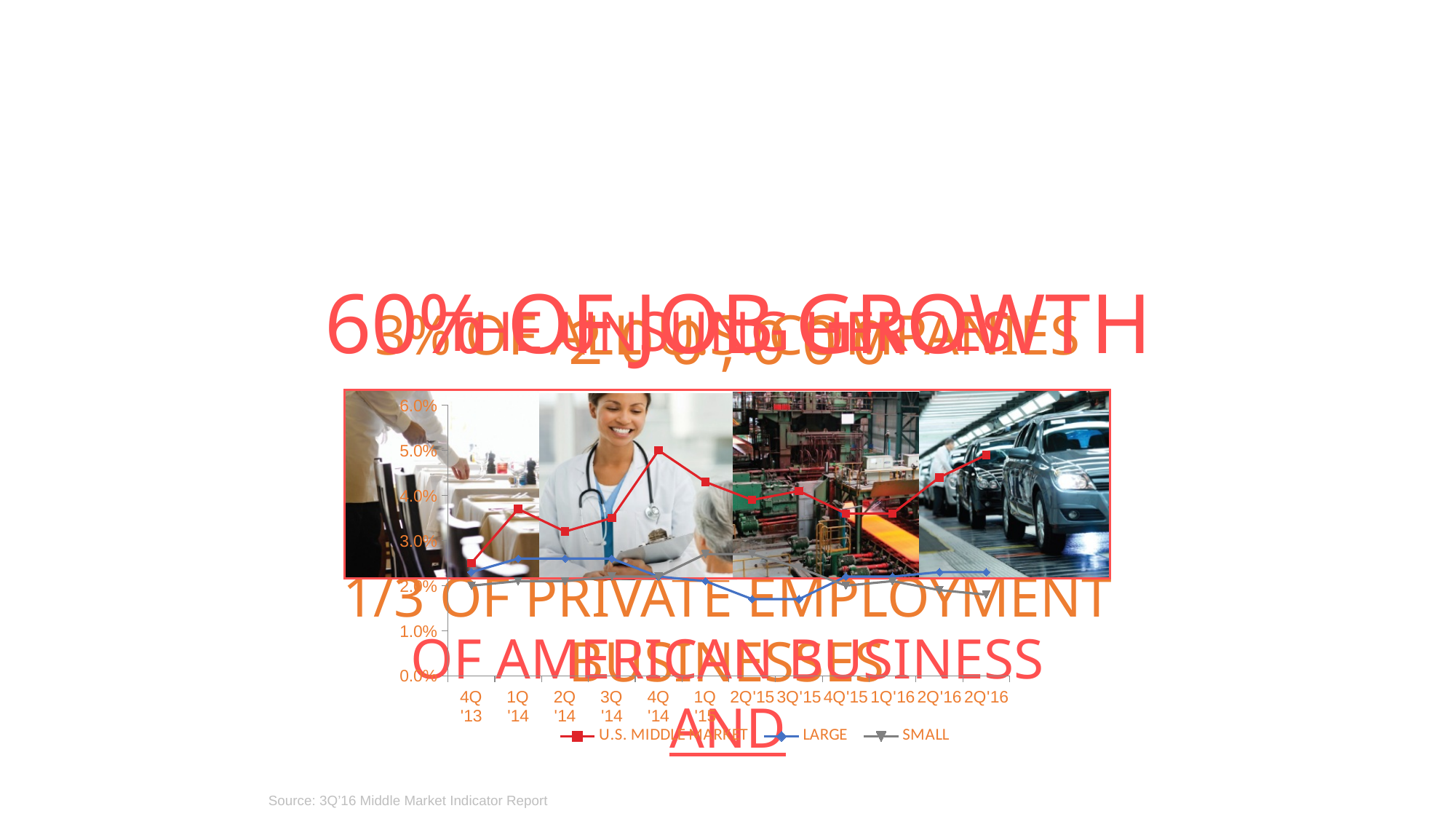
What kind of chart is shown on the slide? line chart Is the U.S. MIDDLE MARKET value at 4Q '14 greater or less than 4.0%? greater Does the U.S. MIDDLE MARKET series rise or fall from 4Q '13 to 4Q '14? rise Is the U.S. MIDDLE MARKET value at 4Q '13 greater or less than 3.0%? less How many series does the chart legend list? 3 Is the LARGE value at the final 2Q'16 point greater or less than 3.0%? less In which quarter does the U.S. MIDDLE MARKET series reach its highest value? 4Q '14 What source is cited for the chart? 3Q'16 Middle Market Indicator Report How many quarters are plotted along the x axis? 12 Which series has the highest value at 4Q '14? U.S. MIDDLE MARKET Which series is drawn in red with square markers? U.S. MIDDLE MARKET At 4Q '14, which is larger: the U.S. MIDDLE MARKET value or the LARGE value? U.S. MIDDLE MARKET